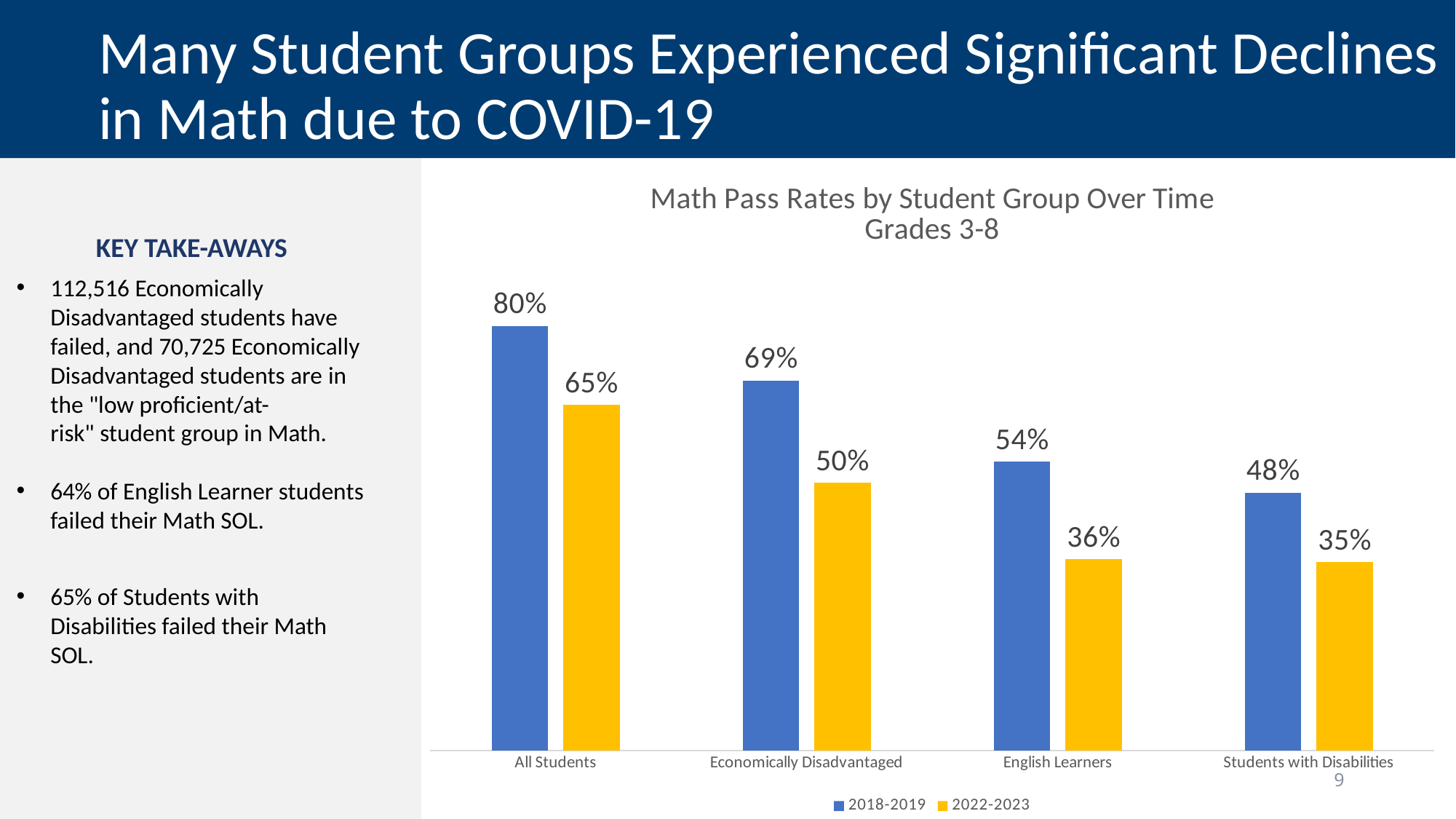
Which is larger: the 2022-2023 pass rate for Economically Disadvantaged students or the 2018-2019 pass rate for Students with Disabilities? 2022-2023 pass rate for Economically Disadvantaged students How many student groups are shown on the x axis of the chart? 4 Which student group had the highest math pass rate in 2022-2023? All Students By how many percentage points did the math pass rate for Economically Disadvantaged students fall from 2018-2019 to 2022-2023? 19 percentage points What was the math pass rate for English Learners in 2022-2023? 36% What type of chart is used to show math pass rates by student group? Bar chart What was the math pass rate for All Students in 2018-2019? 80% Which student group had the lowest math pass rate in 2022-2023? Students with Disabilities How many series does the chart legend list? 2 What is the difference between the 2018-2019 pass rates of All Students and English Learners? 26 percentage points Which colour represents the 2022-2023 series in the chart? Yellow What was the math pass rate for Students with Disabilities in 2018-2019? 48%